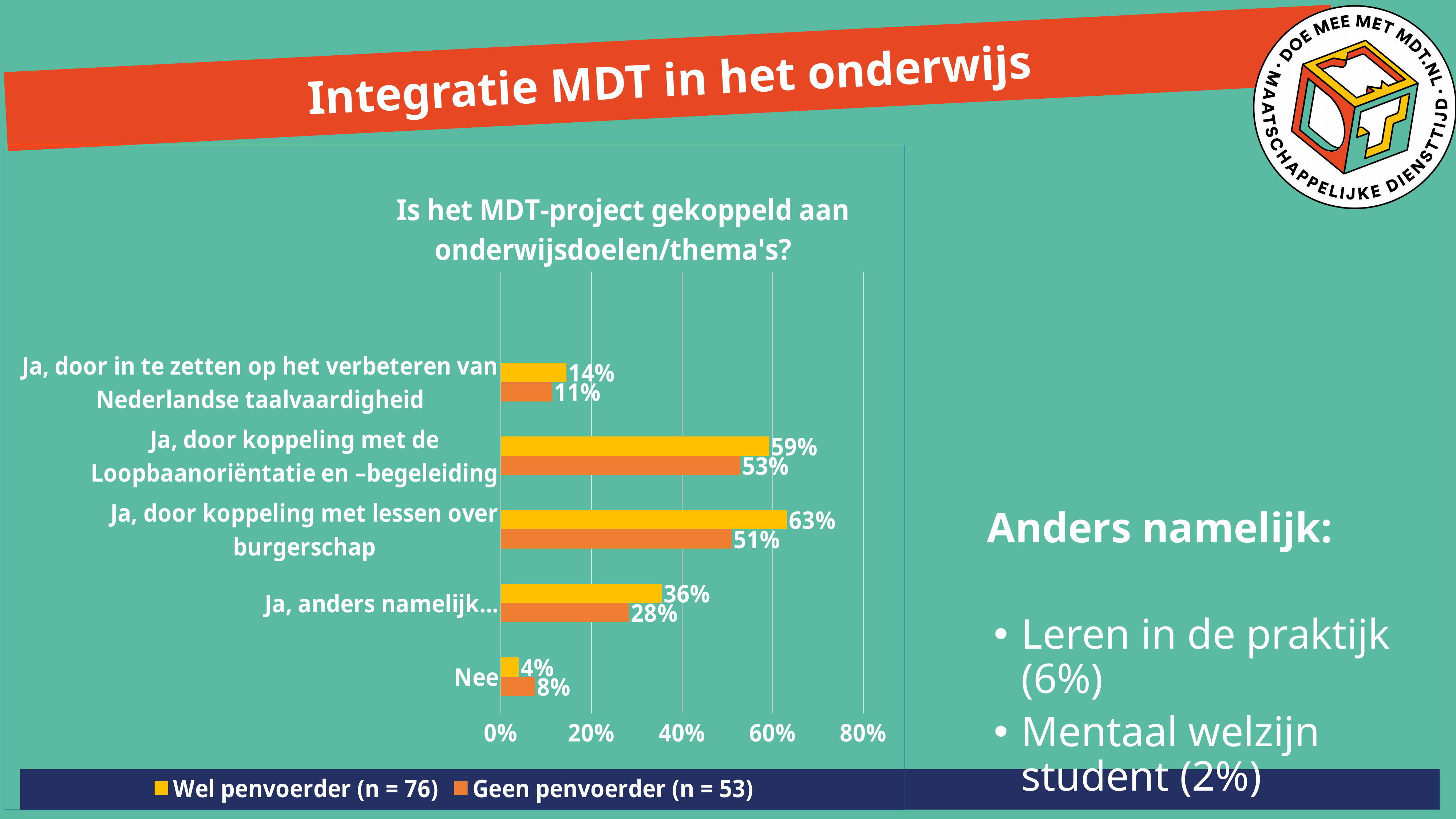
What kind of chart is shown on the slide? Bar chart What is the value for "Wel penvoerder (n = 76)" for "Ja, anders namelijk..."? 36% What is the difference between "Wel penvoerder (n = 76)" and "Geen penvoerder (n = 53)" for "Ja, door koppeling met lessen over burgerschap"? 12% Which category has the highest value for "Wel penvoerder (n = 76)"? Ja, door koppeling met lessen over burgerschap What is the value for "Wel penvoerder (n = 76)" for "Ja, door koppeling met lessen over burgerschap"? 63% How many series does the legend list? 2 For "Nee", which series has the larger value: "Wel penvoerder (n = 76)" or "Geen penvoerder (n = 53)"? Geen penvoerder (n = 53) Which category has the lowest value for "Geen penvoerder (n = 53)"? Nee What is the value for "Geen penvoerder (n = 53)" for "Ja, door koppeling met de Loopbaanoriëntatie en –begeleiding"? 53% What is the title of the chart? Is het MDT-project gekoppeld aan onderwijsdoelen/thema's? How many categories are shown on the chart? 5 What is the value for "Geen penvoerder (n = 53)" for "Nee"? 8%